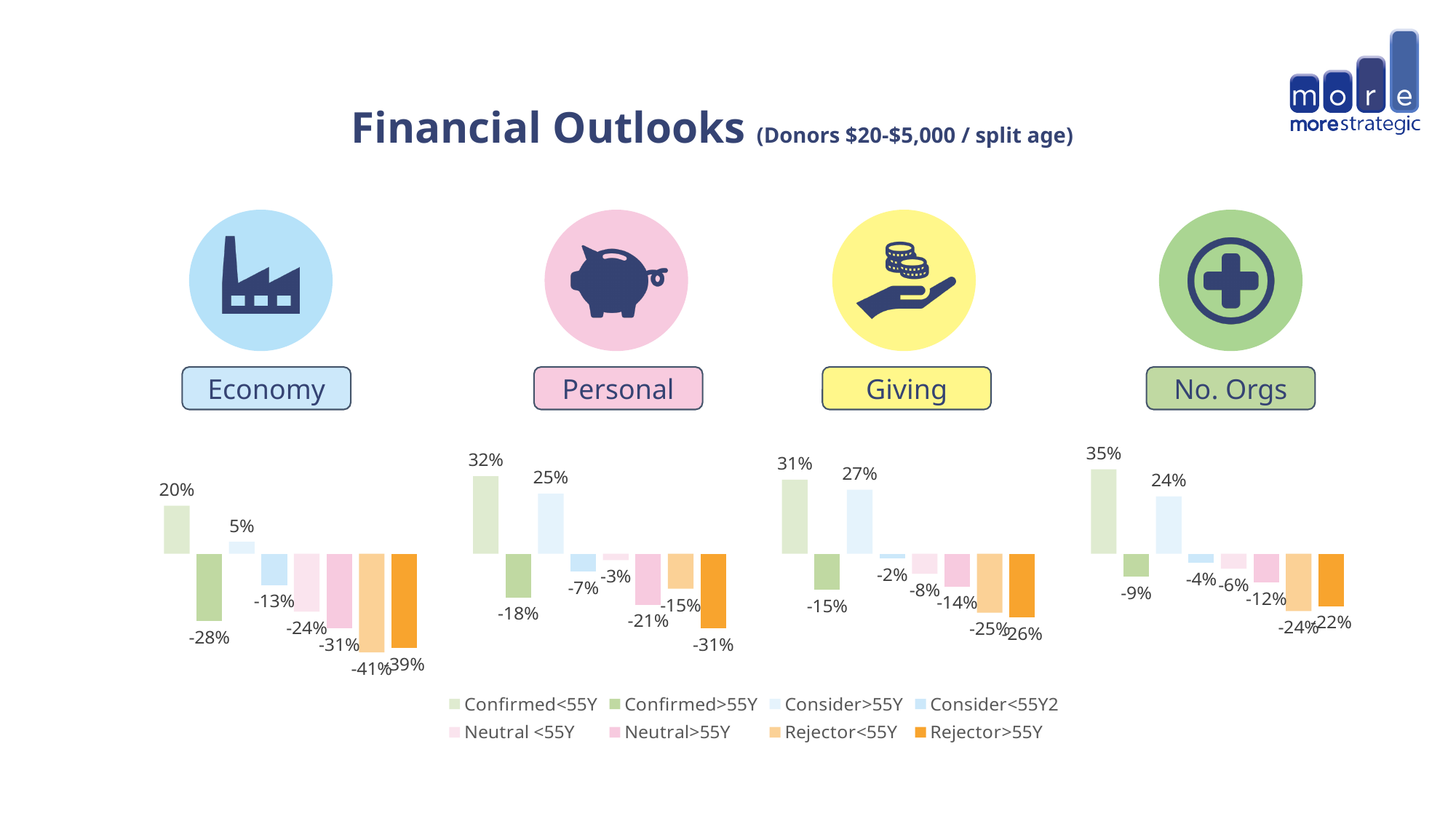
What kind of chart is used for the Economy data? Bar chart In the No. Orgs chart, which is larger, the value for Confirmed<55Y or the value for Consider>55Y? Confirmed<55Y In the Giving chart, what is the difference between the Confirmed<55Y value and the Consider>55Y value? 4% What is the title of the slide? Financial Outlooks How many bars are plotted in the Personal chart? 8 How many series does the legend list? 8 In the Economy chart, what is the value for Confirmed<55Y? 20% In the Personal chart, what is the value for Consider>55Y? 25% In the No. Orgs chart, what is the value for Neutral>55Y? -12% In the Economy chart, which series has the highest value? Confirmed<55Y In the Personal chart, which series has the lowest value? Rejector>55Y In the Giving chart, what is the value for Confirmed>55Y? -15%